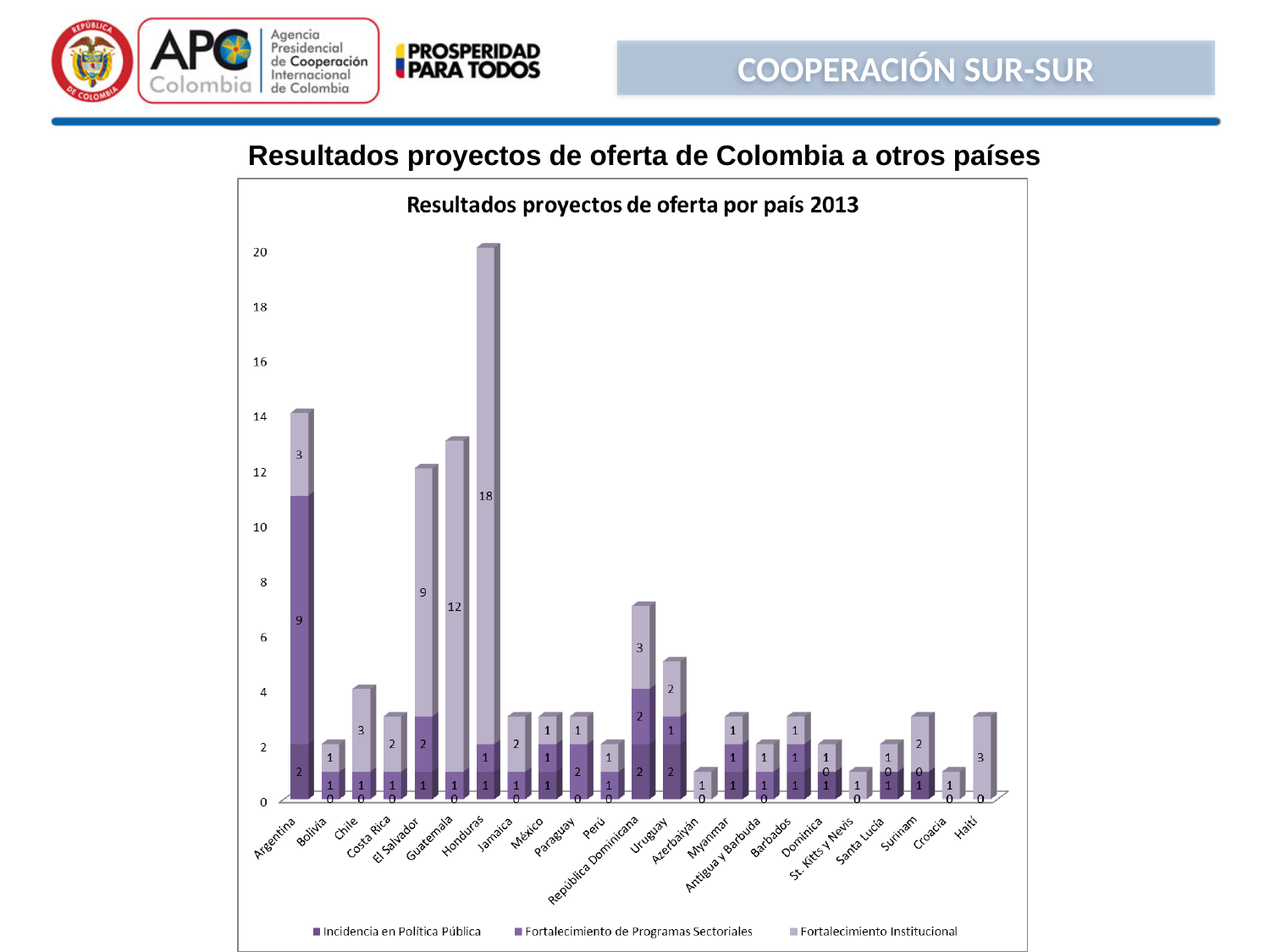
How many countries are shown on the x axis? 23 How many series does the legend list? 3 What is the value of Fortalecimiento Institucional for Honduras? 18 What is the value of Fortalecimiento Institucional for Guatemala? 12 What kind of chart is shown on the slide? Stacked bar chart What is the value of Fortalecimiento Institucional for El Salvador? 9 What is the total of the stacked bar for Argentina? 14 What is the difference between the Fortalecimiento Institucional values for Honduras and Guatemala? 6 Which country has the highest total stacked bar? Honduras What is the value of Fortalecimiento de Programas Sectoriales for Argentina? 9 Which has a larger total stacked bar, Argentina or El Salvador? Argentina What is the total of the stacked bar for República Dominicana? 7